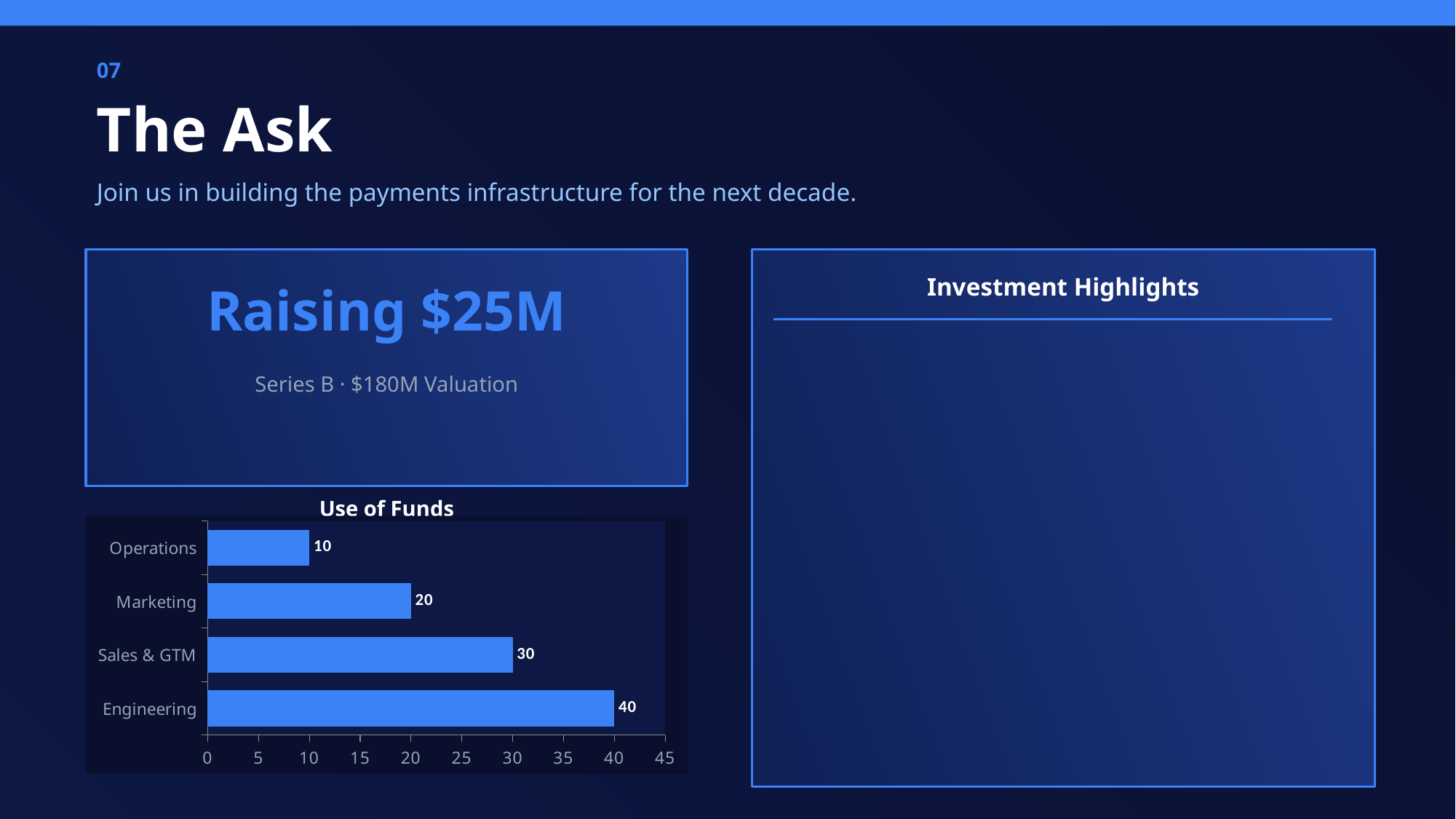
What is the value for Operations in the Use of Funds chart? 10 What kind of chart is the Use of Funds chart? Bar chart How many categories are shown in the Use of Funds chart? 4 Which category has the lowest value in the Use of Funds chart? Operations What is the title of the chart on the slide? Use of Funds Which is larger in the Use of Funds chart, Sales & GTM or Marketing? Sales & GTM Is the value for Sales & GTM in the Use of Funds chart greater or less than 25? greater Which category has the highest value in the Use of Funds chart? Engineering What is the value for Marketing in the Use of Funds chart? 20 What is the value for Sales & GTM in the Use of Funds chart? 30 What is the difference between the Engineering and Marketing values in the Use of Funds chart? 20 What is the value for Engineering in the Use of Funds chart? 40